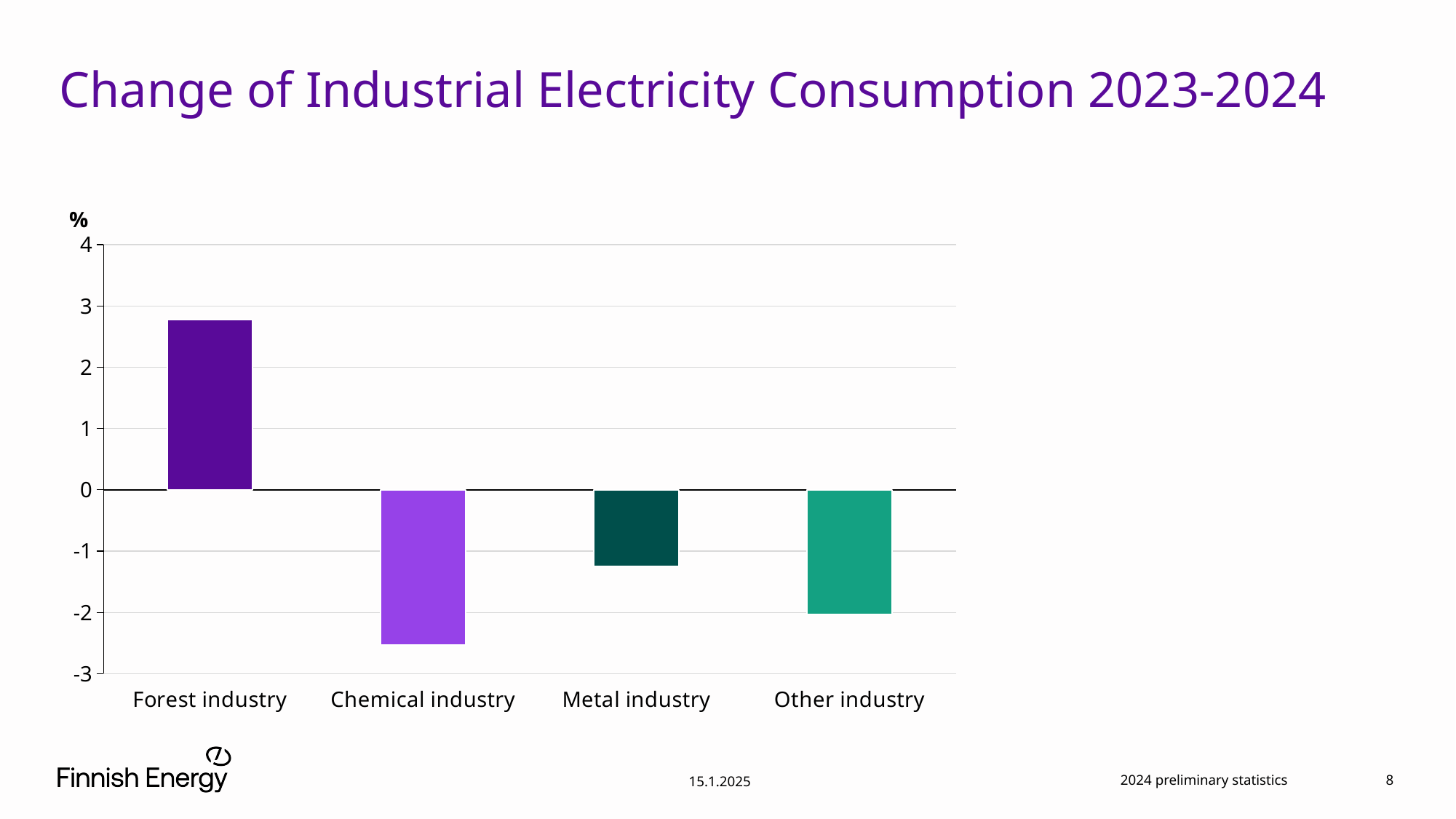
Which is larger, the value for Metal industry or the value for Other industry? Metal industry How many industry categories are plotted in the chart? 4 Which industry has the highest change in electricity consumption? Forest industry What kind of chart is shown on the slide? bar chart Is the value for Forest industry greater or less than 2? greater What is the title of the chart on the slide? Change of Industrial Electricity Consumption 2023-2024 Is the value for Metal industry greater or less than -1? less Which is larger, the value for Forest industry or the value for Chemical industry? Forest industry Is the value for Metal industry greater or less than -2? greater What unit is shown on the vertical axis of the chart? % Which industry has the lowest change in electricity consumption? Chemical industry